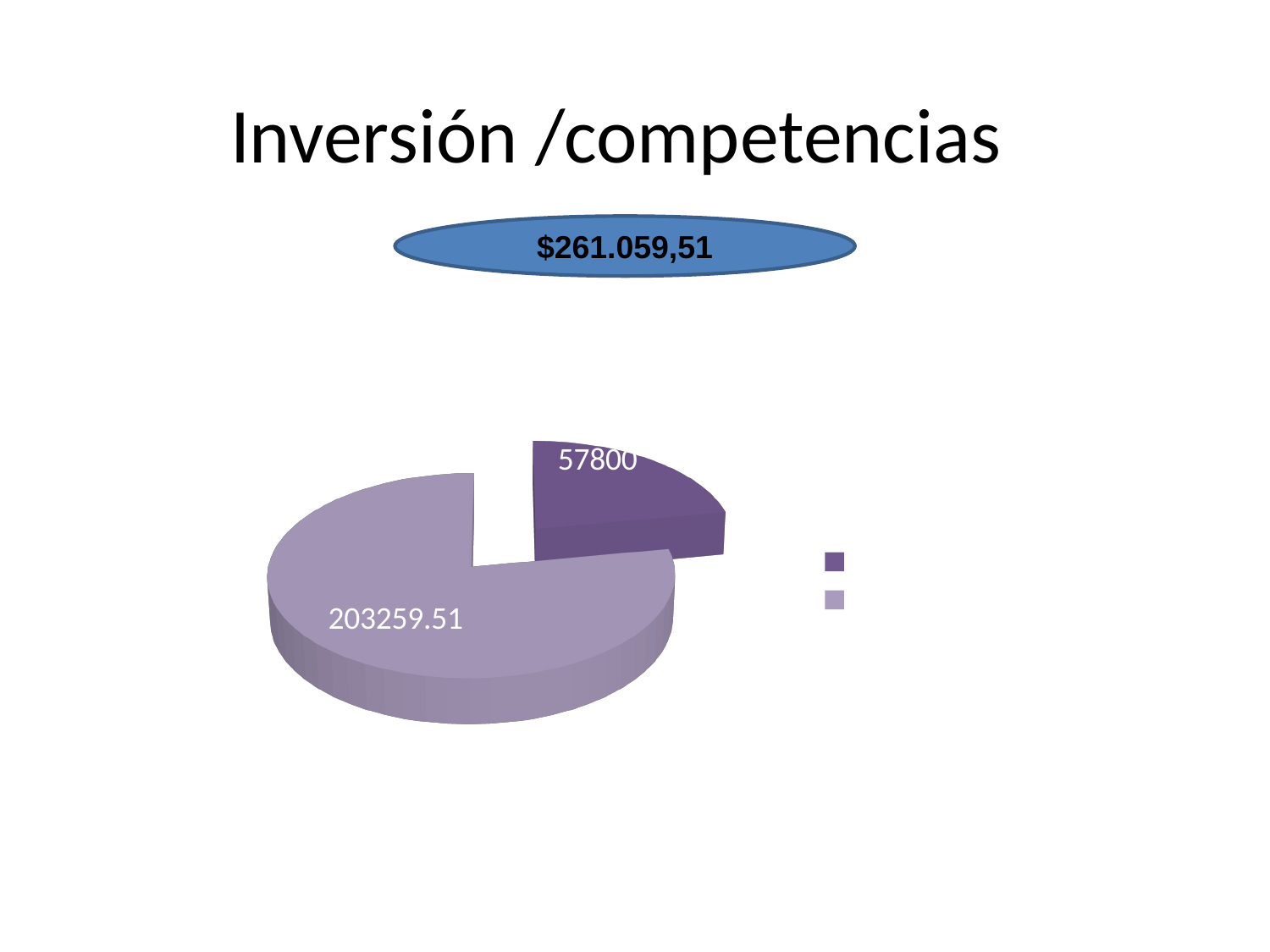
What amount is written in the blue oval above the pie chart? $261.059,51 What is the value of the smallest slice in the pie chart? 57800 How many slices does the pie chart have? 2 What value is labelled on the light purple slice of the pie chart? 203259.51 Which slice is larger, the dark purple one or the light purple one? the light purple one How many entries does the legend of the pie chart show? 2 What is the value of the largest slice in the pie chart? 203259.51 What is the difference between the two slice values in the pie chart? 145459.51 What kind of chart is shown on the slide? pie chart What is the title of the slide containing the pie chart? Inversión /competencias What is the sum of the two slice values in the pie chart? 261059.51 What value is labelled on the dark purple, exploded slice of the pie chart? 57800